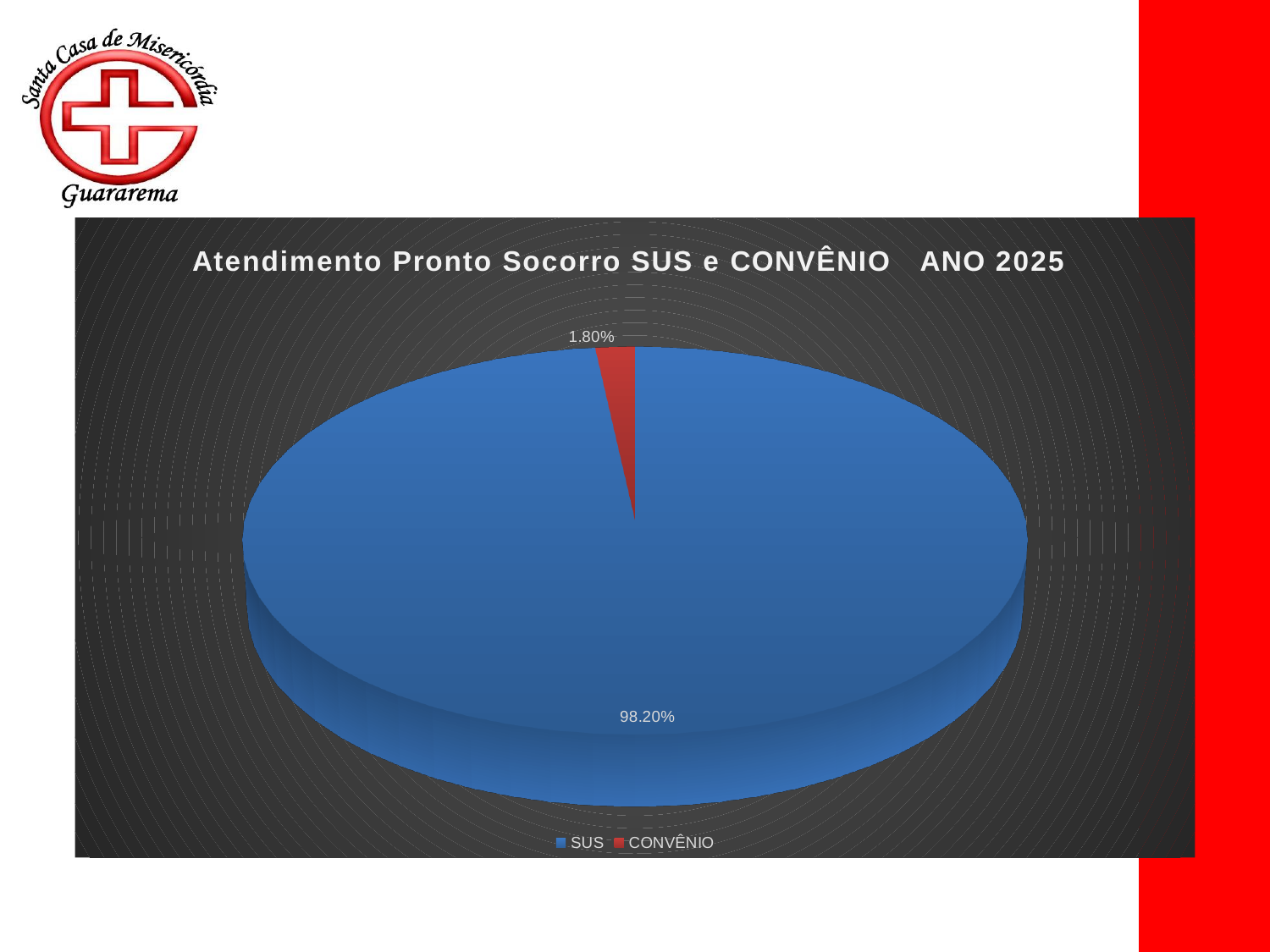
What is the title of the chart? Atendimento Pronto Socorro SUS e CONVÊNIO ANO 2025 Which category has the smallest slice of the pie? CONVÊNIO Which is larger, the SUS slice or the CONVÊNIO slice? SUS What colour is the CONVÊNIO slice? red What share of the pie does SUS represent? 98.20% What share of the pie does CONVÊNIO represent? 1.80% Which category has the largest slice of the pie? SUS What is the difference in percentage points between the SUS and CONVÊNIO slices? 96.40% How many entries does the legend list? 2 How many categories does the pie chart show? 2 What kind of chart is shown on the slide? pie chart